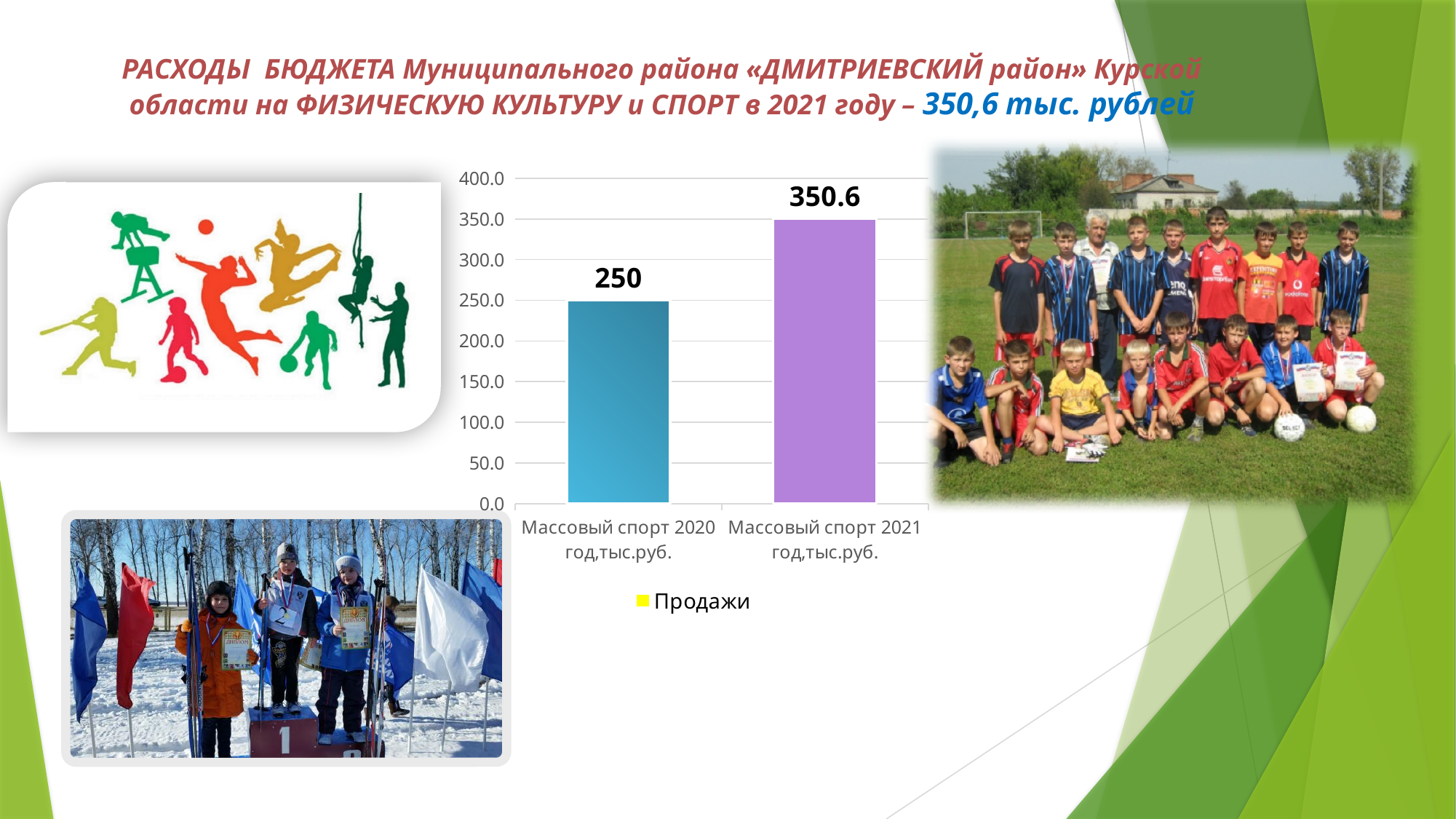
Which category has the highest value? Массовый спорт 2021 год,тыс.руб. What is the legend entry shown below the chart? Продажи Which is larger: the value for Массовый спорт 2020 год,тыс.руб. or for Массовый спорт 2021 год,тыс.руб.? Массовый спорт 2021 год,тыс.руб. What is the value for Массовый спорт 2021 год,тыс.руб.? 350.6 How many series does the legend list? 1 What kind of chart is shown on the slide? bar chart What is the value for Массовый спорт 2020 год,тыс.руб.? 250 Is the value for Массовый спорт 2020 год,тыс.руб. greater or less than 300.0? less Is the value for Массовый спорт 2021 год,тыс.руб. greater or less than 300.0? greater What is the difference between the values for Массовый спорт 2021 год,тыс.руб. and Массовый спорт 2020 год,тыс.руб.? 100.6 Which category has the lowest value? Массовый спорт 2020 год,тыс.руб. How many categories are shown on the chart? 2